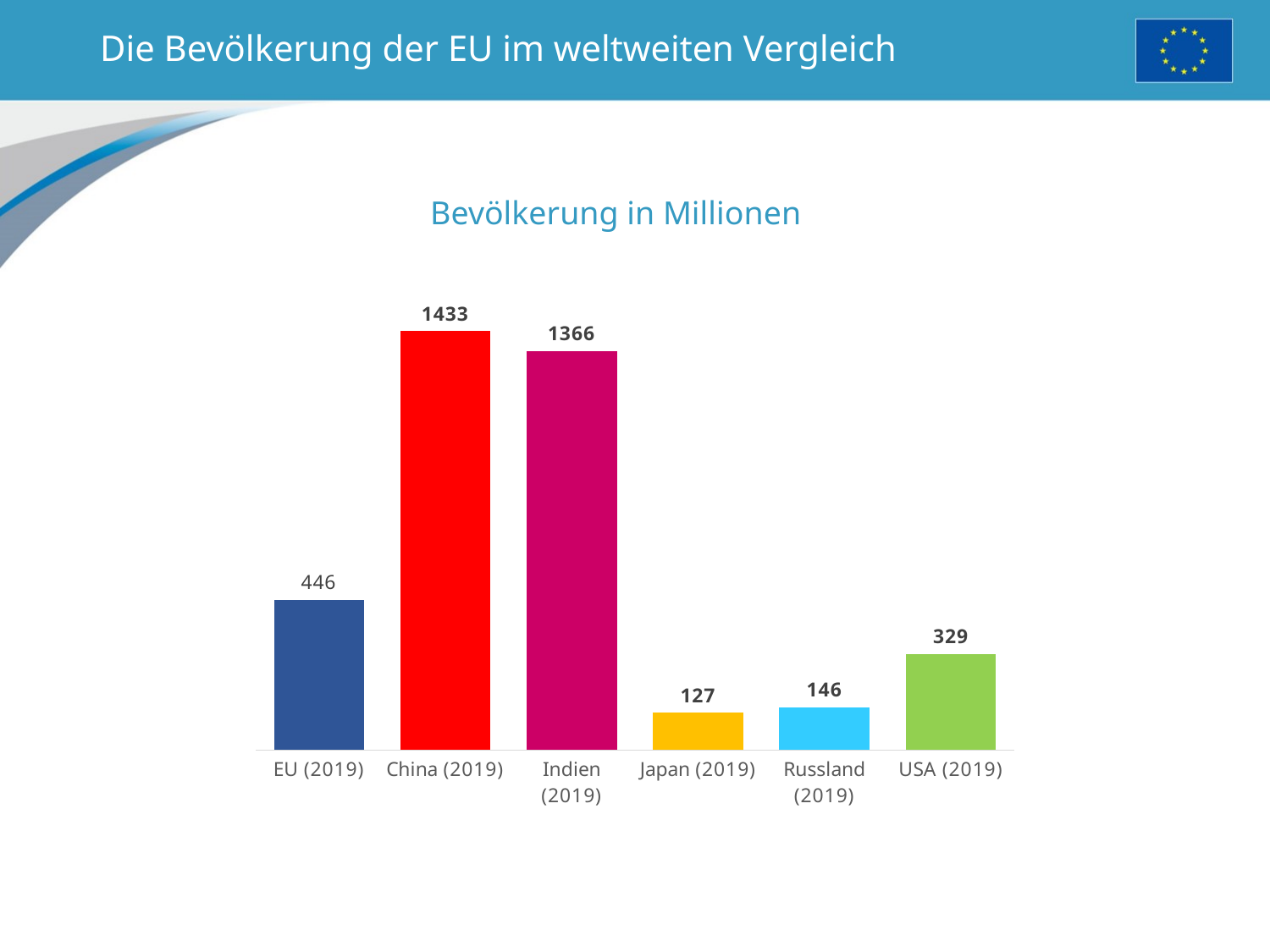
What is the value for EU (2019)? 446 What is the difference between the values for China (2019) and Indien (2019)? 67 How many categories are shown in the chart? 6 What is the value for USA (2019)? 329 Which is larger, the value for Russland (2019) or the value for Japan (2019)? Russland (2019) What is the value for Japan (2019)? 127 What is the difference between the values for EU (2019) and USA (2019)? 117 What is the title of the chart? Bevölkerung in Millionen What kind of chart is shown on the slide? Bar chart Which category has the highest value? China (2019) Which category has the lowest value? Japan (2019) What is the value for China (2019)? 1433